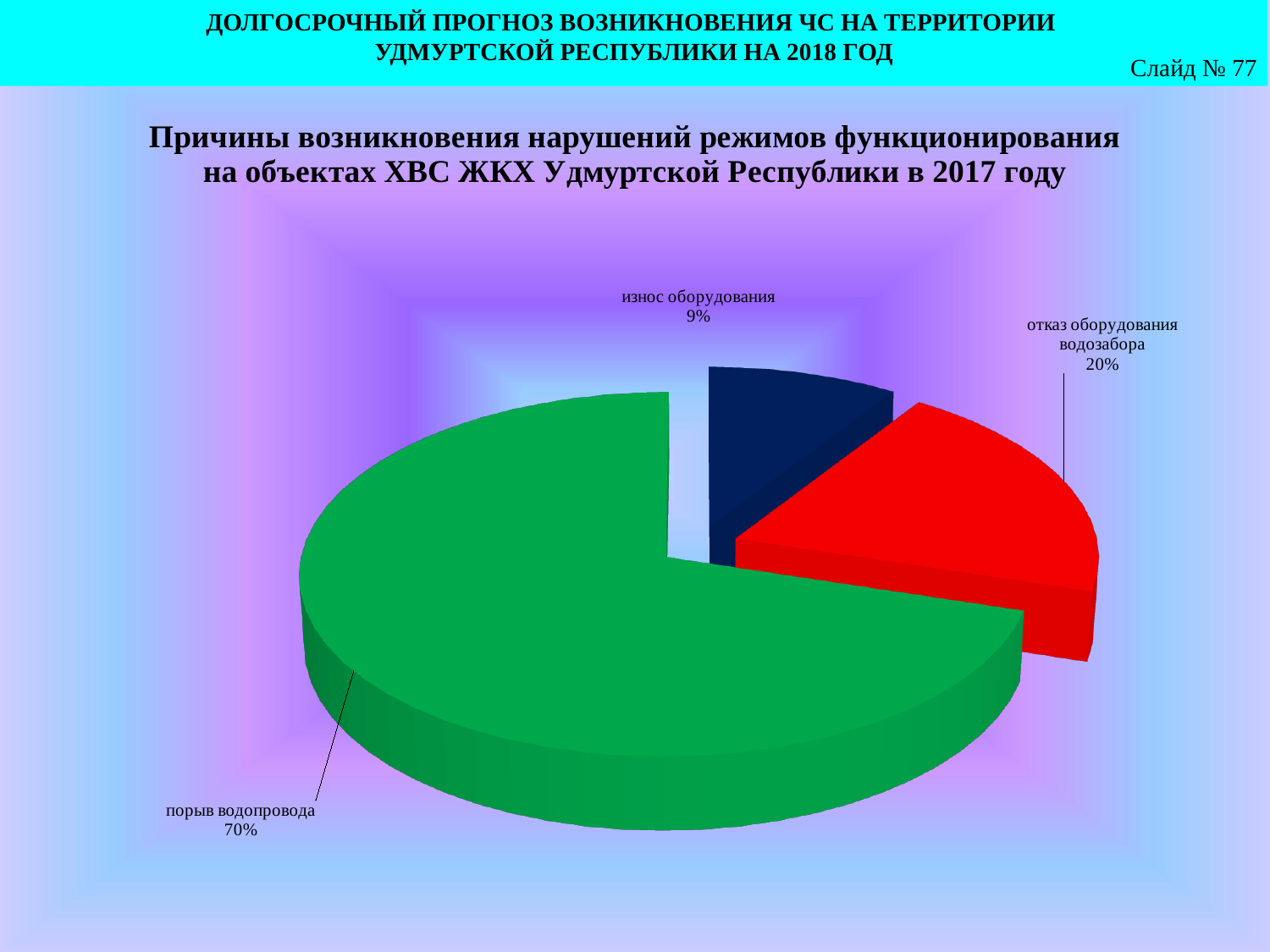
What share of the pie does 'отказ оборудования водозабора' have? 20% What share of the pie does 'порыв водопровода' have? 70% What is the difference in percentage points between 'отказ оборудования водозабора' and 'износ оборудования'? 11 What share of the pie does 'износ оборудования' have? 9% Which is larger: the share for 'отказ оборудования водозабора' or for 'износ оборудования'? отказ оборудования водозабора How many slices does the pie chart have? 3 What is the difference in percentage points between 'порыв водопровода' and 'отказ оборудования водозабора'? 50 What colour is the slice for 'порыв водопровода'? green Which category has the smallest slice of the pie? износ оборудования What colour is the slice for 'отказ оборудования водозабора'? red What kind of chart is shown on the slide? pie chart Which category has the largest slice of the pie? порыв водопровода